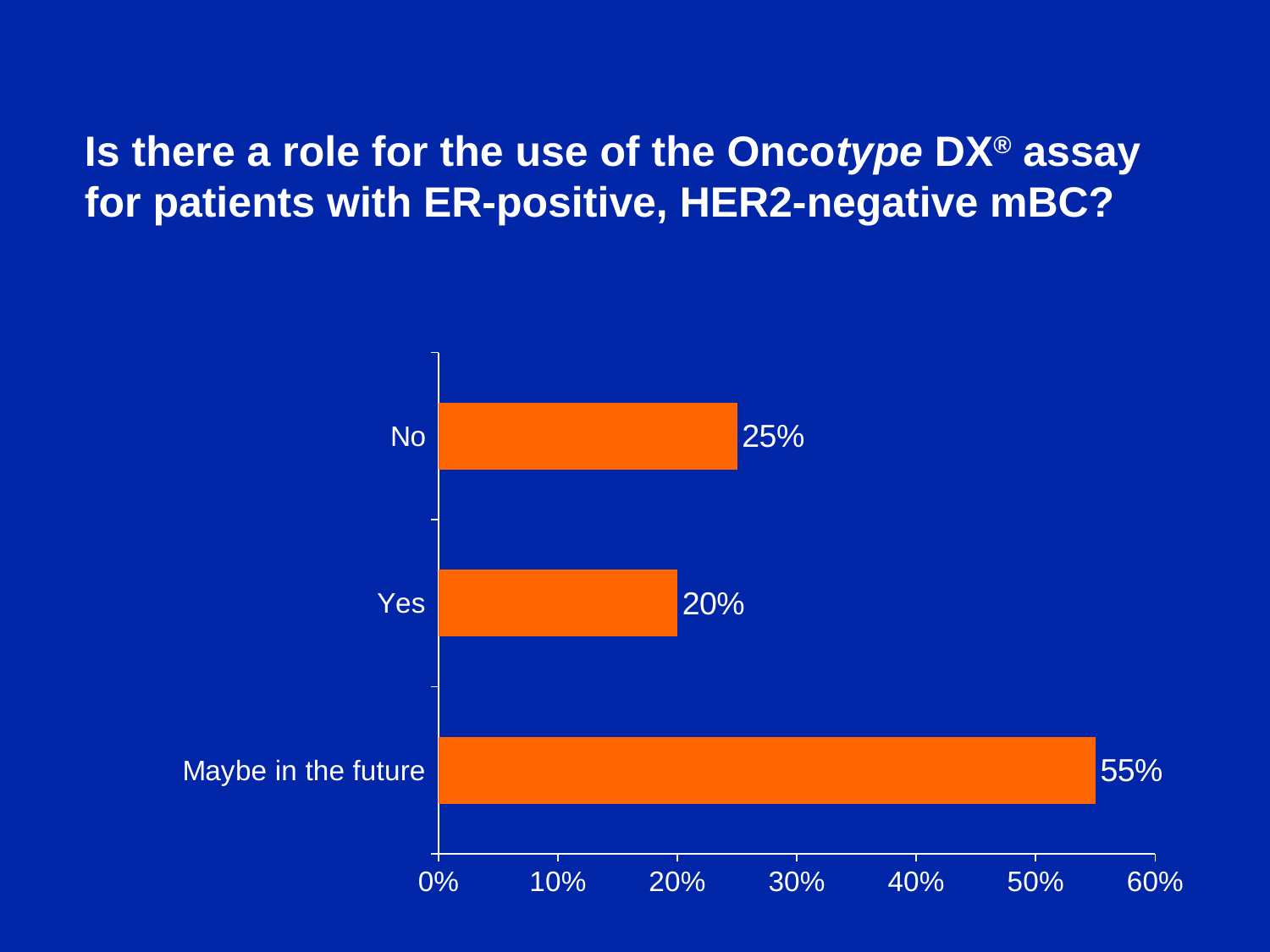
What is the difference in percentage points between "Maybe in the future" and "No"? 30% Is the value for "Maybe in the future" greater or less than 50%? greater Which response has a larger percentage, "No" or "Yes"? No What kind of chart is shown on the slide? Bar chart What percentage of respondents answered "Yes"? 20% Which response has the lowest percentage? Yes Which response has the highest percentage? Maybe in the future How many response categories are shown in the chart? 3 What is the maximum value shown on the horizontal axis? 60% What percentage of respondents answered "Maybe in the future"? 55% What is the difference in percentage points between "No" and "Yes"? 5% What percentage of respondents answered "No"? 25%